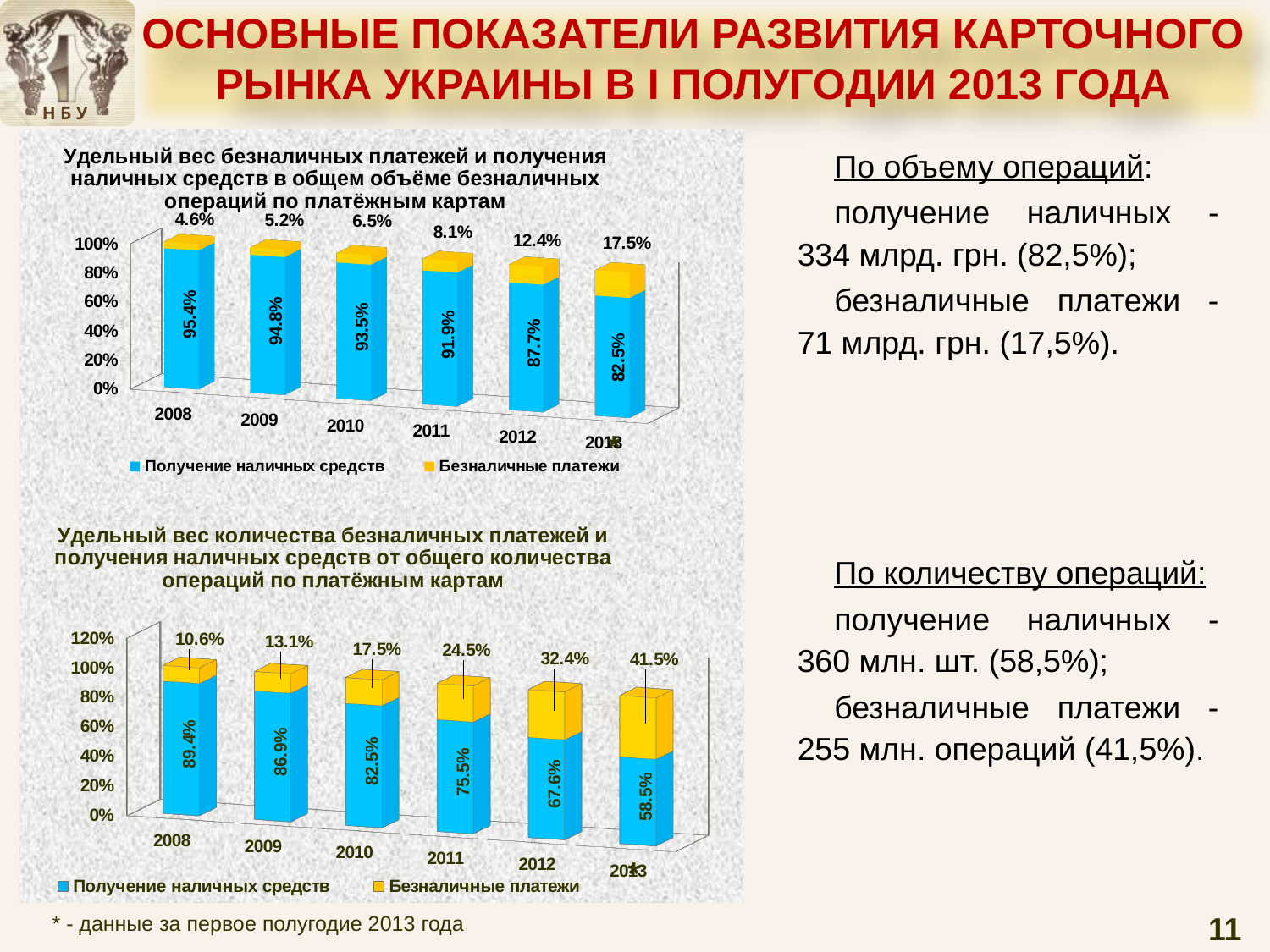
In the top chart, which year has the highest value for Безналичные платежи? 2013 In the top chart, what is the difference between the Безналичные платежи values for 2013 and 2008? 12.9% In the top chart, what is the value for Получение наличных средств in 2008? 95.4% In the top chart, what is the value for Безналичные платежи in 2013? 17.5% In the bottom chart, which year has the lowest value for Получение наличных средств? 2013 In the bottom chart, what is the value for Получение наличных средств in 2012? 67.6% In the top chart, how many years are shown on the x axis? 6 What type of chart is the bottom chart? bar chart In the top chart, does the value for Получение наличных средств rise or fall from 2008 to 2013? fall In the bottom chart, which is larger in 2013: Получение наличных средств or Безналичные платежи? Получение наличных средств In the bottom chart, what is the value for Безналичные платежи in 2011? 24.5% How many series does the legend of the bottom chart list? 2